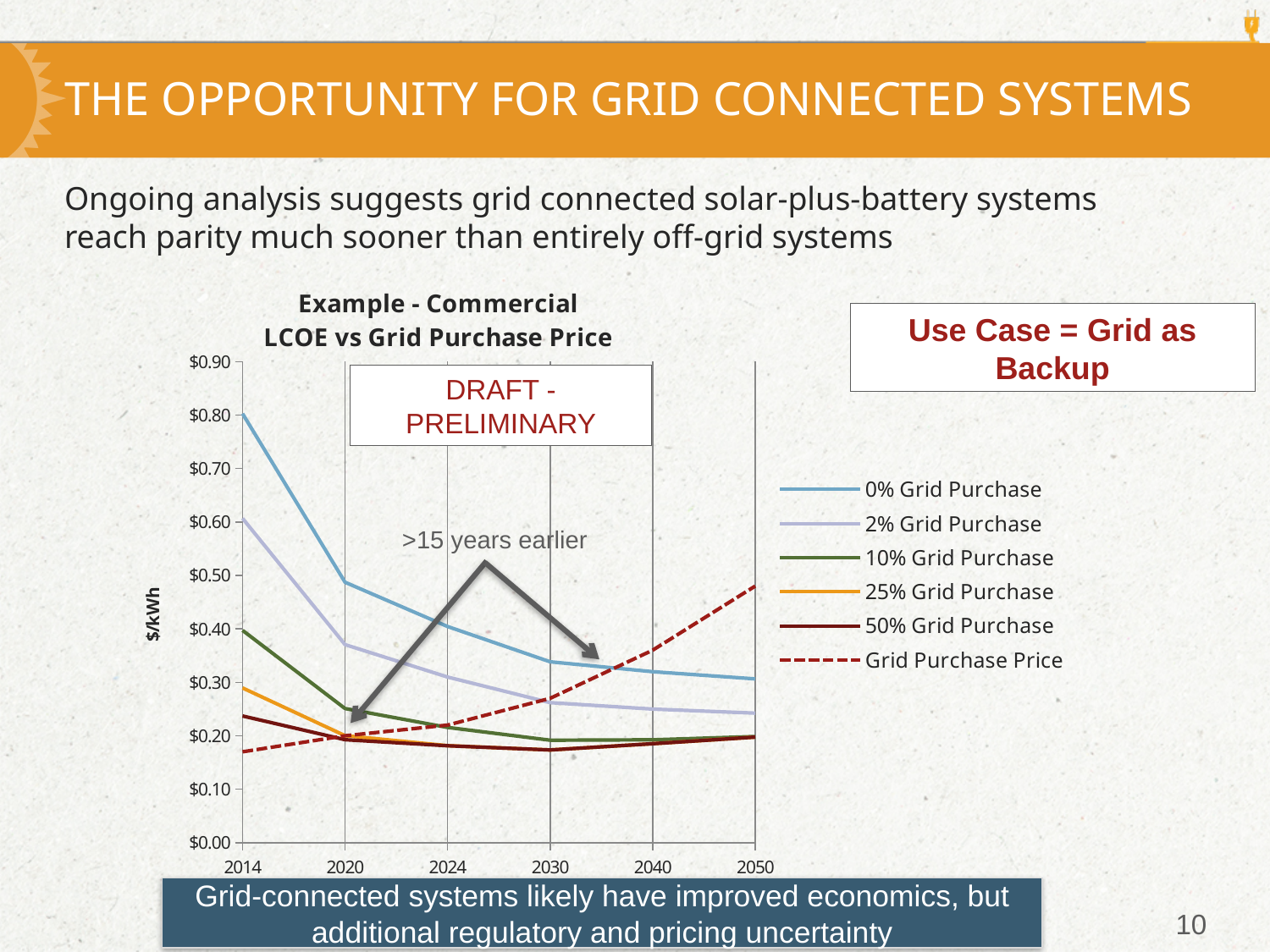
What kind of chart is shown on the slide? Line chart In 2050, which is higher: the 0% Grid Purchase line or the Grid Purchase Price line? Grid Purchase Price What is the label on the y axis of the chart? $/kWh Does the Grid Purchase Price line rise or fall from 2014 to 2050? Rise Is the value for 10% Grid Purchase in 2014 greater or less than $0.50? less Is the value for 0% Grid Purchase in 2014 greater or less than $0.70? greater What is the title of the chart? Example - Commercial LCOE vs Grid Purchase Price Is the value for Grid Purchase Price in 2050 greater or less than $0.40? greater Which series has the highest value in 2014? 0% Grid Purchase How many series does the chart legend list? 6 Does the 0% Grid Purchase line rise or fall from 2014 to 2050? Fall How many years are labelled on the x axis of the chart? 6